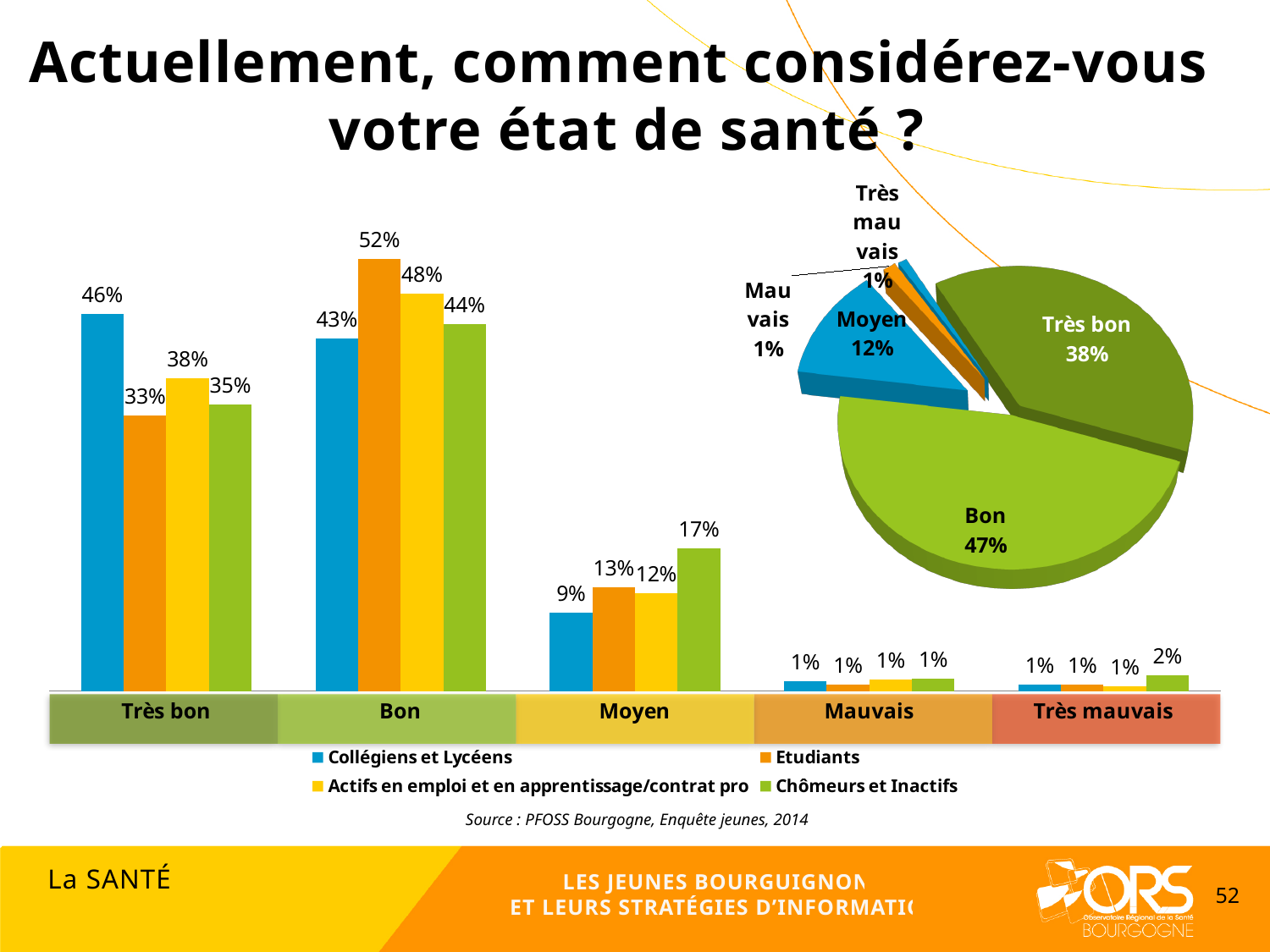
In the bar chart, what is the value for Chômeurs et Inactifs in the Moyen category? 17% In the bar chart, what is the difference between the Etudiants and Collégiens et Lycéens values in the Bon category? 9% In the pie chart, which slice is the largest? Bon In the bar chart, which is larger in the Très bon category: Actifs en emploi et en apprentissage/contrat pro or Chômeurs et Inactifs? Actifs en emploi et en apprentissage/contrat pro How many series does the legend of the bar chart list? 4 In the bar chart, what is the value for Etudiants in the Bon category? 52% What kind of chart is the chart on the right of the slide? Pie chart In the bar chart, what is the value for Collégiens et Lycéens in the Très bon category? 46% In the pie chart, what share does the Bon slice have? 47% In the bar chart, which series has the highest value in the Très bon category? Collégiens et Lycéens How many categories are shown on the x axis of the bar chart? 5 In the bar chart, which series has the lowest value in the Moyen category? Collégiens et Lycéens